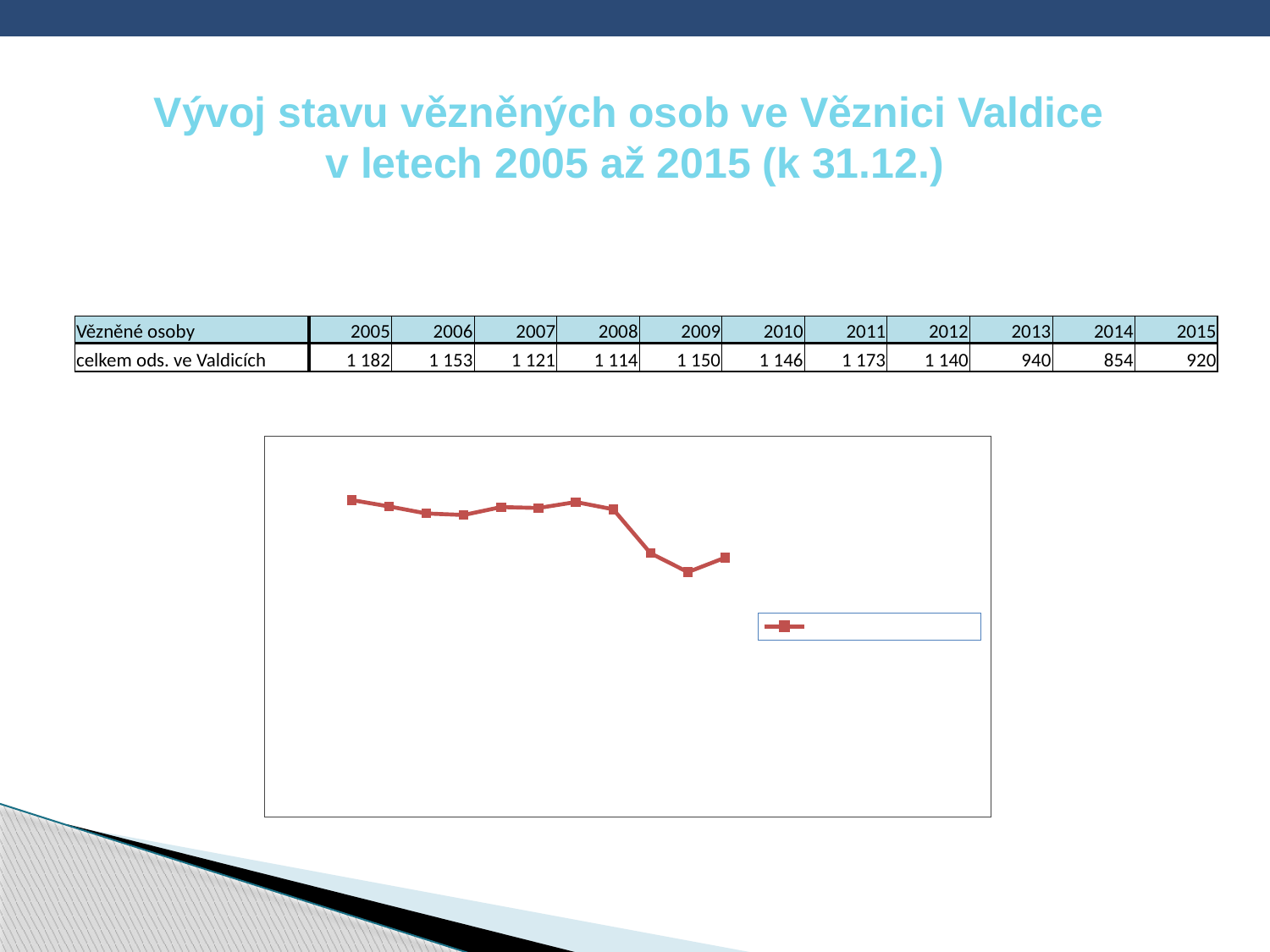
How many series does the chart's legend show? 1 According to the table above the chart, what was the number of prisoners in Valdice in 2011? 1 173 Which year has the highest value in the table above the chart? 2005 According to the table above the chart, what was the number of prisoners in Valdice in 2005? 1 182 What colour is the line plotted on the chart? red Using the table above the chart, what is the difference between the 2005 value and the 2015 value? 262 According to the table above the chart, what was the number of prisoners in Valdice in 2014? 854 What kind of chart is shown on the slide? line chart Overall, do the plotted values rise or fall from the first point to the last point? fall Using the table above the chart, which year has the larger value, 2013 or 2015? 2013 Which year has the lowest value in the table above the chart? 2014 How many data points are plotted on the line chart? 11